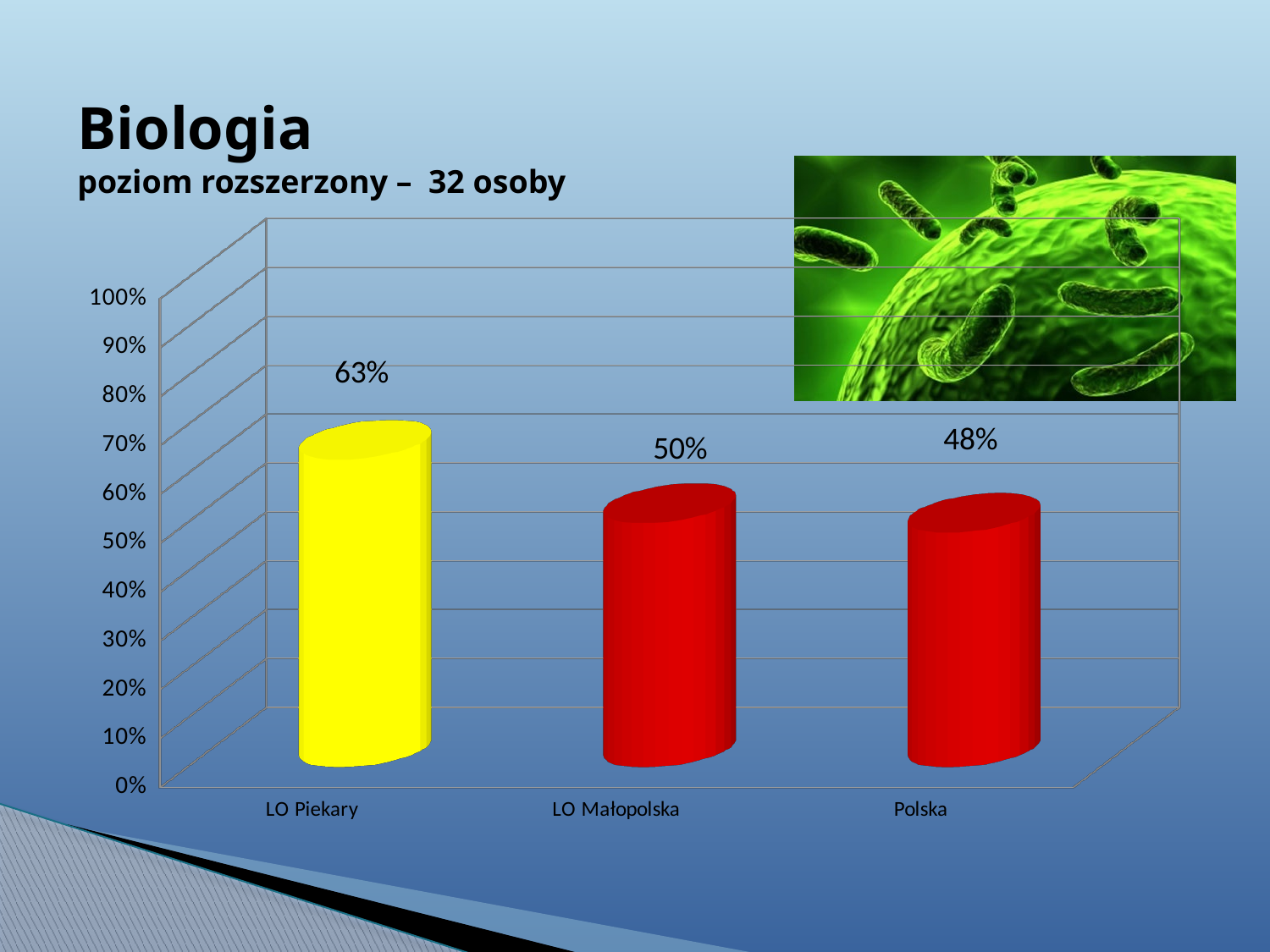
What is the difference between the values for LO Piekary and LO Małopolska? 13% What is the value for Polska? 48% Which category has the highest value? LO Piekary What kind of chart is shown on the slide? bar chart What is the value for LO Małopolska? 50% How many categories are shown on the chart? 3 Which category has the lowest value? Polska Which is larger, the value for LO Piekary or the value for LO Małopolska? LO Piekary What is the difference between the values for LO Piekary and Polska? 15% What is the value for LO Piekary? 63% What colour is the bar for LO Piekary? yellow Is the value for LO Piekary greater or less than 60%? greater